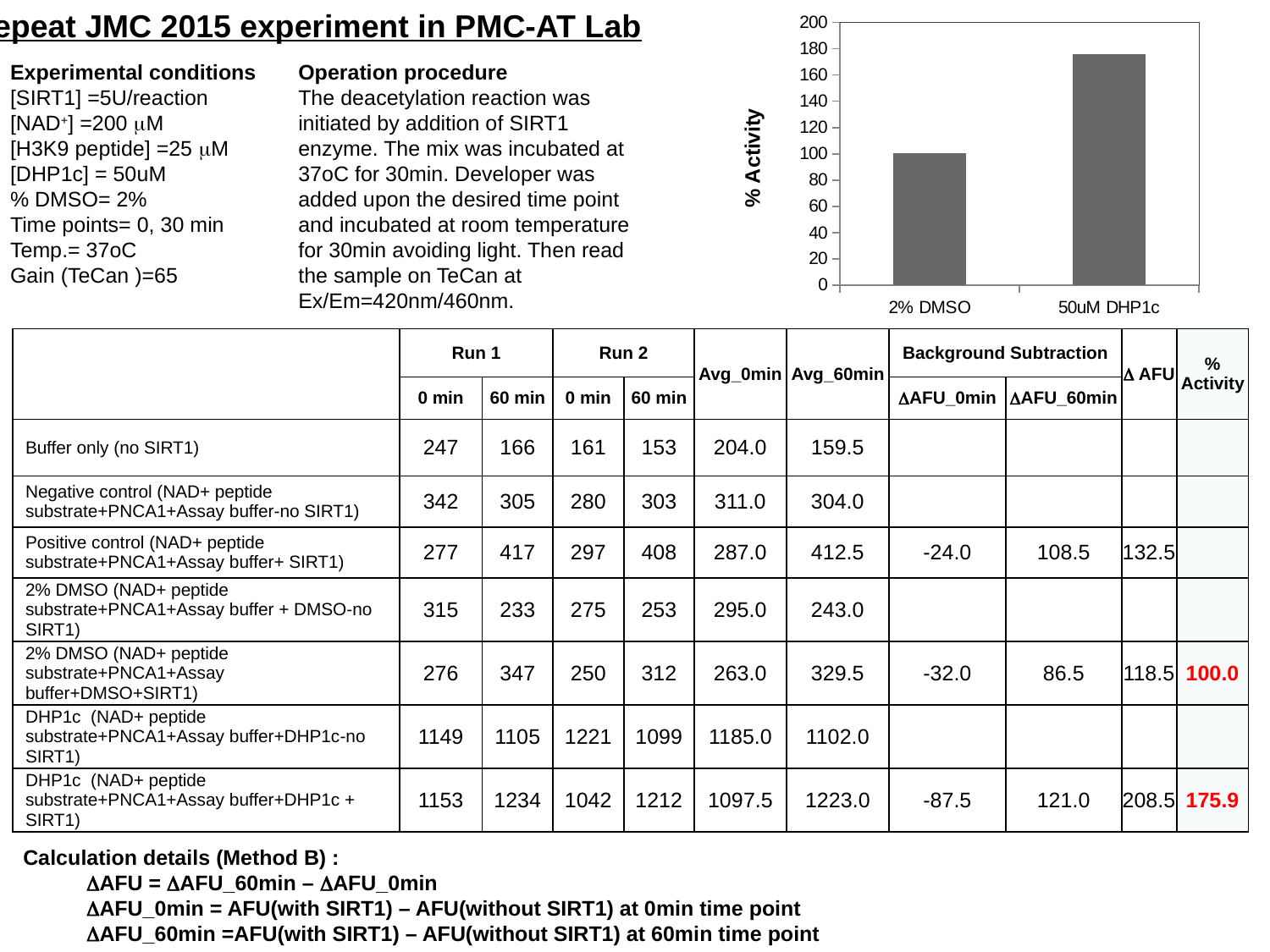
What type of chart is shown on the slide? bar chart Is the value for 50uM DHP1c greater or less than 160? greater Is the value for 50uM DHP1c greater or less than 180? less What is the label on the vertical axis of the chart? % Activity Is the value for 2% DMSO greater or less than 120? less Which category has the highest bar in the chart? 50uM DHP1c What is the % Activity value for 2% DMSO in the chart? 100 Which category has the lowest bar in the chart? 2% DMSO Which bar is taller, 2% DMSO or 50uM DHP1c? 50uM DHP1c How many bars are plotted in the chart? 2 Do the bar values rise or fall from 2% DMSO to 50uM DHP1c? rise What is the maximum value shown on the chart's vertical axis? 200